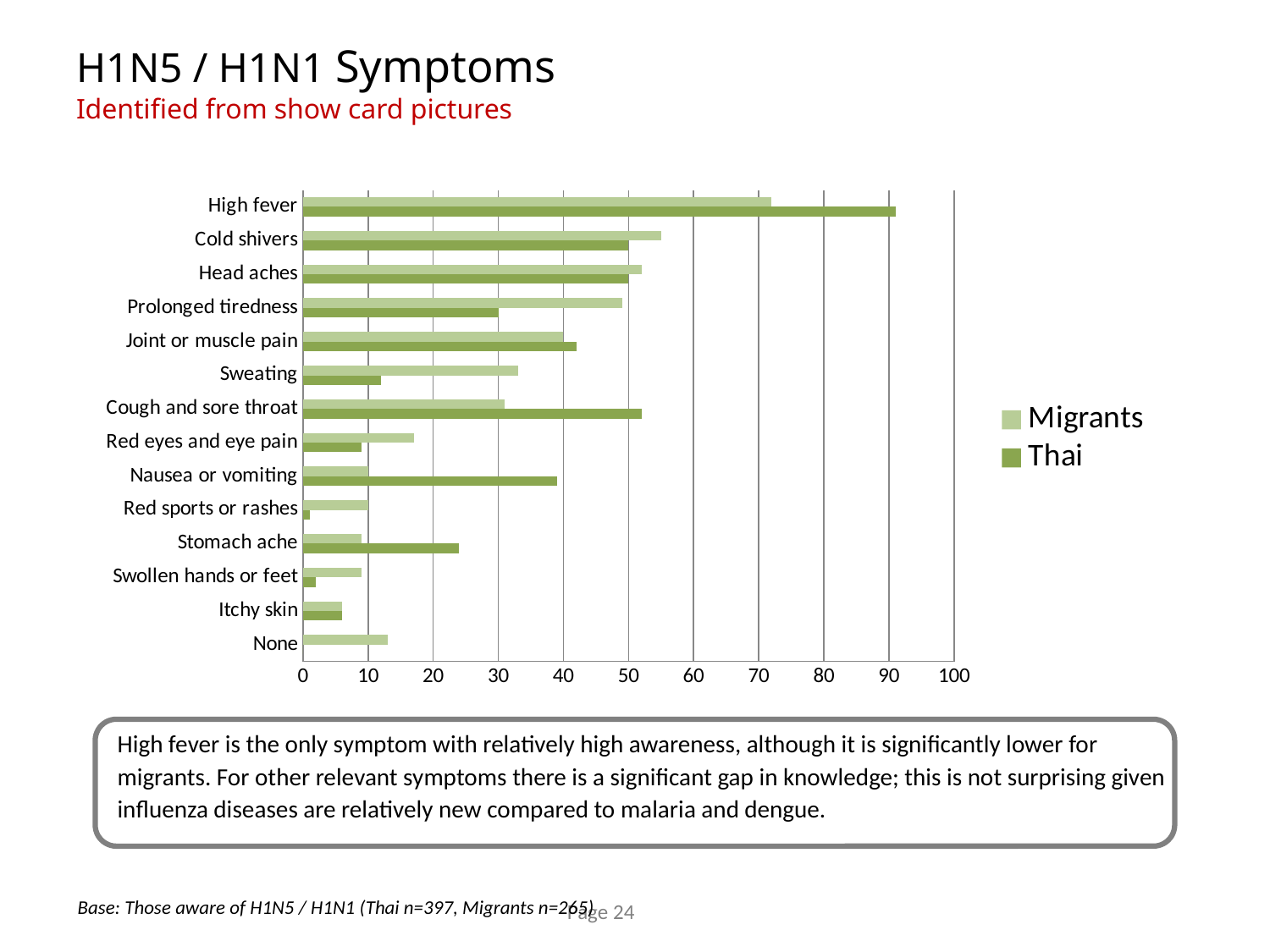
Is the Thai value for Nausea or vomiting greater or less than 30? greater Which symptom has the highest value for the Migrants series? High fever What kind of chart is shown on the slide? bar chart Is the Thai value for Sweating greater or less than 20? less Which symptom has the highest value for the Thai series? High fever What are the two series named in the legend? Migrants and Thai For Cough and sore throat, which series has the larger value, Migrants or Thai? Thai How many series does the legend list? 2 Is the Migrants value for High fever greater or less than 70? greater How many symptom categories are plotted on the chart? 14 For Prolonged tiredness, which series has the larger value, Migrants or Thai? Migrants